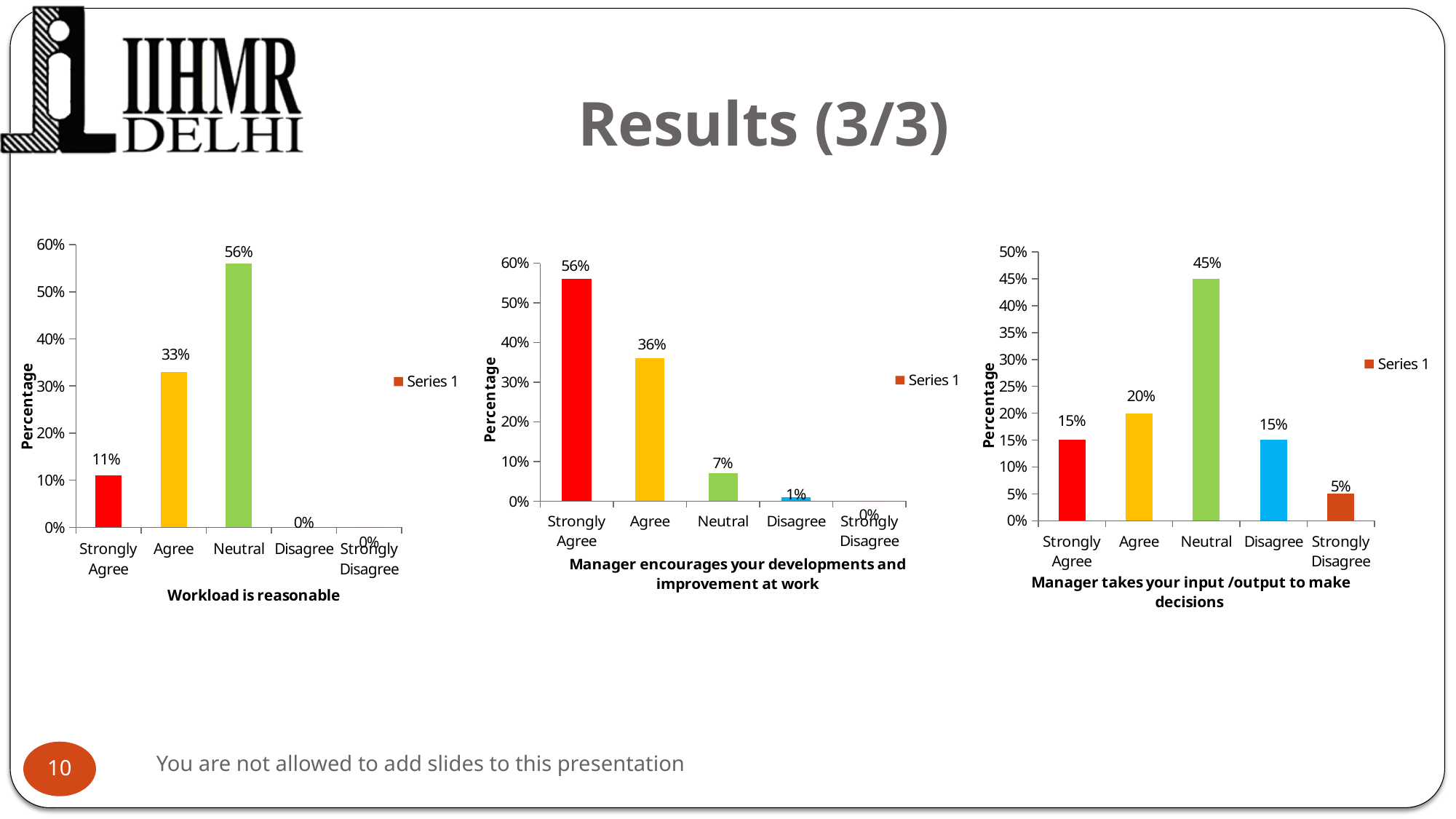
In the 'Manager encourages your developments and improvement at work' chart, what is the value for Strongly Agree? 56% In the 'Workload is reasonable' chart, which category has the highest value? Neutral How many categories are shown on the x axis of the 'Workload is reasonable' chart? 5 In the 'Manager encourages your developments and improvement at work' chart, which is larger, Agree or Neutral? Agree In the 'Manager takes your input /output to make decisions' chart, what is the value for Neutral? 45% In the 'Manager takes your input /output to make decisions' chart, which category has the lowest value? Strongly Disagree In the 'Manager encourages your developments and improvement at work' chart, what is the value for Disagree? 1% In the 'Manager takes your input /output to make decisions' chart, what is the difference between Neutral and Agree? 25% What kind of chart is the 'Manager takes your input /output to make decisions' chart? Bar chart How many series does the legend of the 'Manager encourages your developments and improvement at work' chart list? 1 In the 'Workload is reasonable' chart, what is the value for Neutral? 56% In the 'Workload is reasonable' chart, what is the difference between Agree and Strongly Agree? 22%